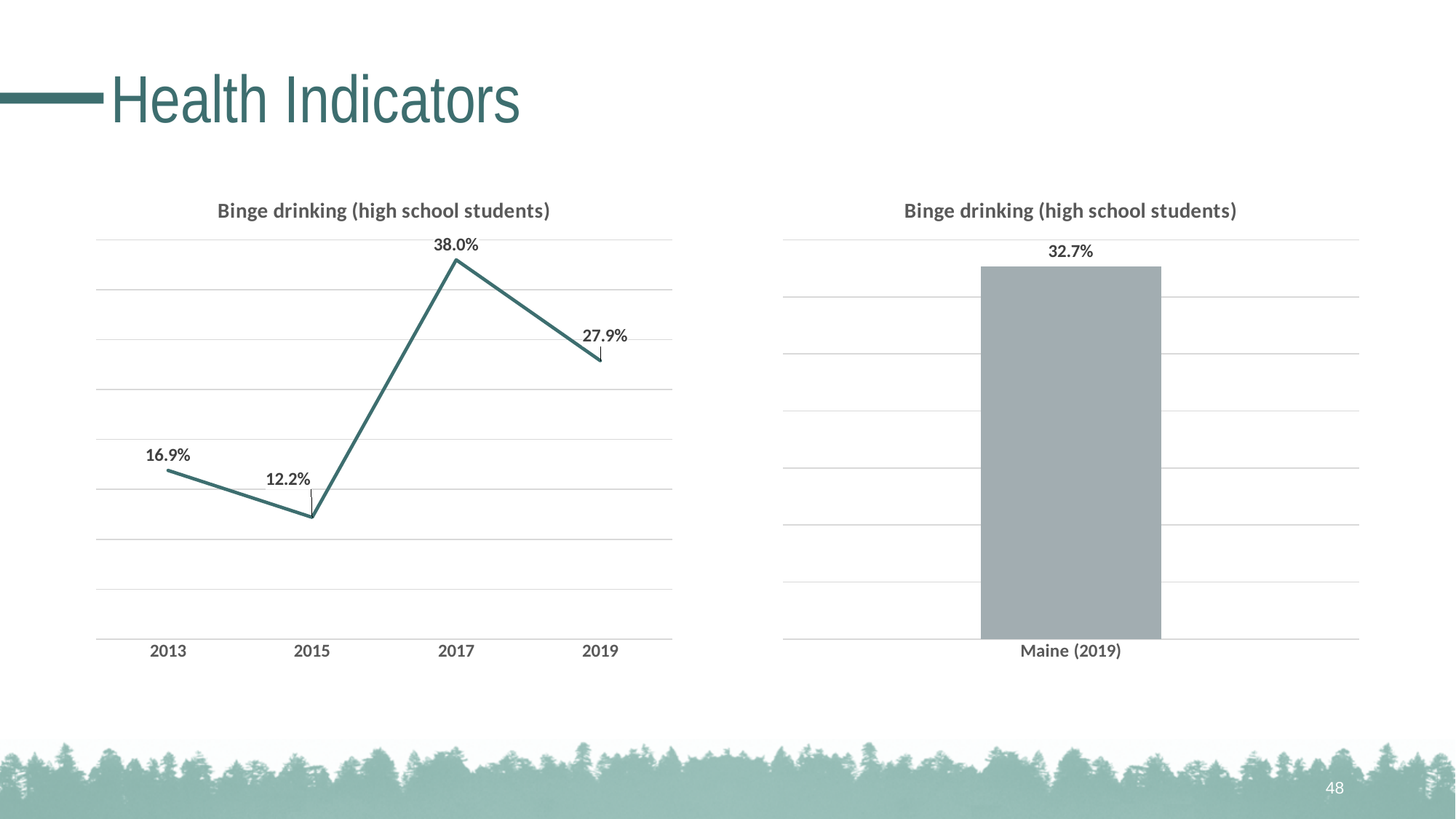
In the left chart (line chart), what is the binge drinking value for 2013? 16.9% In the left chart (line chart), what is the binge drinking value for 2017? 38.0% In the left chart (line chart), what is the binge drinking value for 2019? 27.9% Which is larger: the 2019 value in the left chart or the Maine (2019) value in the right chart? Maine (2019) In the left chart (line chart), what is the binge drinking value for 2015? 12.2% In the left chart (line chart), which year has the lowest binge drinking value? 2015 In the right chart (bar chart), what is the binge drinking value for Maine (2019)? 32.7% What type of chart is the right chart? Bar chart In the left chart (line chart), what is the difference between the 2017 and 2015 values? 25.8% How many data points are plotted in the left chart (line chart)? 4 In the left chart (line chart), which year has the highest binge drinking value? 2017 In the left chart (line chart), does the value rise or fall from 2017 to 2019? Fall